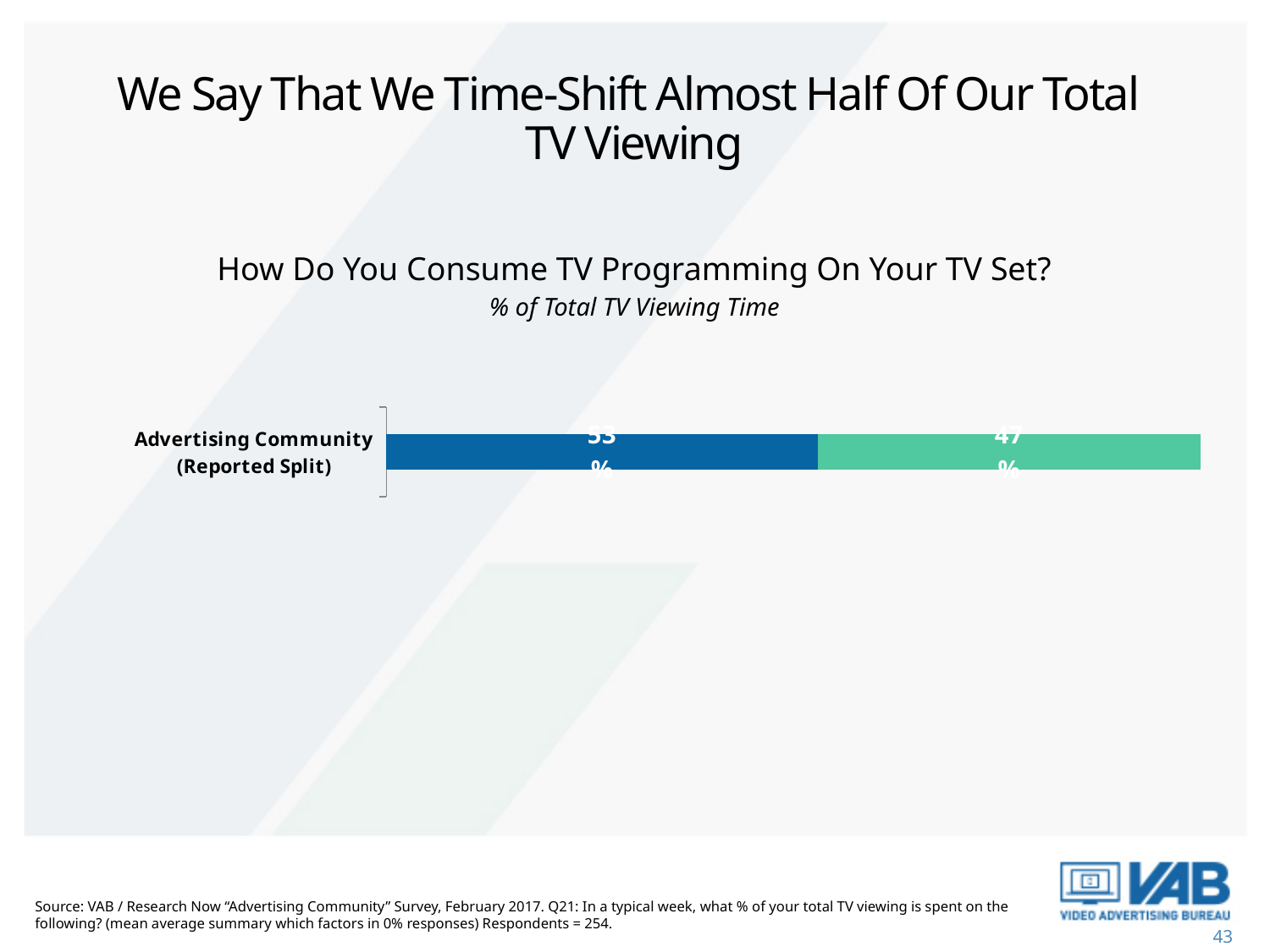
Which segment of the Advertising Community (Reported Split) bar is larger, the blue one or the green one? the blue one What is the title of the chart? How Do You Consume TV Programming On Your TV Set? Is the value of the green segment greater or less than 50%? less What value is shown on the blue segment of the bar for Advertising Community (Reported Split)? 53% What kind of chart is shown on the slide? stacked bar chart What is the total of the two segments in the Advertising Community (Reported Split) bar? 100% What is the label of the single category plotted in the chart? Advertising Community (Reported Split) Is the value of the blue segment greater or less than 50%? greater What value is shown on the green segment of the bar for Advertising Community (Reported Split)? 47% How many categories (bars) are plotted in the chart? 1 What unit does the chart subtitle say the values are measured in? % of Total TV Viewing Time By how many percentage points does the blue segment exceed the green segment in the Advertising Community (Reported Split) bar? 6